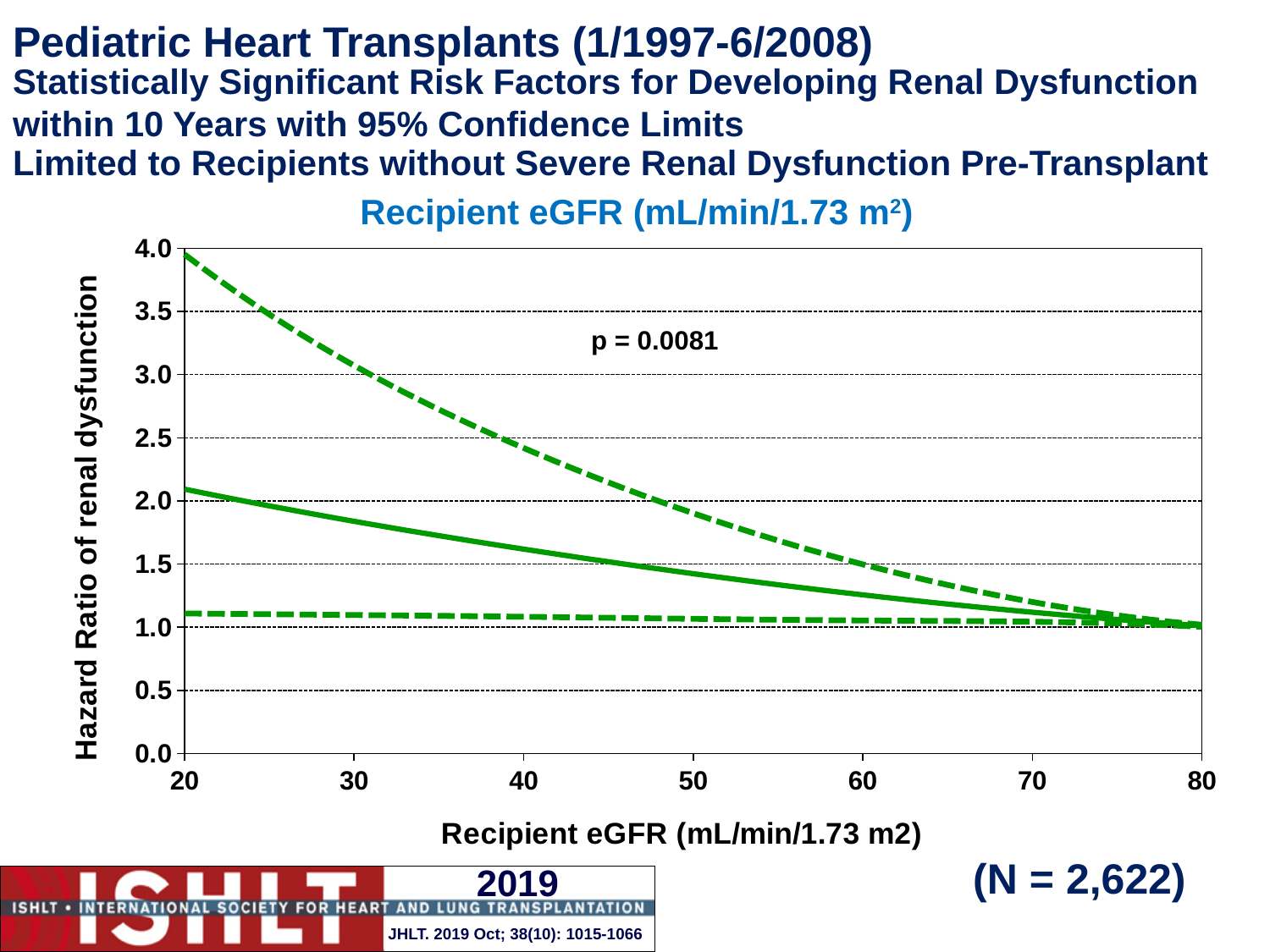
Is the value of the upper dashed line at an eGFR of 20 greater or less than 3.5? greater Is the value of the solid hazard ratio line at an eGFR of 20 greater or less than 1.5? greater Is the value of the solid hazard ratio line at an eGFR of 80 greater or less than 1.5? less What p-value is printed on the chart? p = 0.0081 Does the solid line (hazard ratio) rise or fall as recipient eGFR increases from 20 to 80? fall How many lines are plotted on the chart? 3 At an eGFR of 30, which line is higher: the upper dashed line or the solid line? the upper dashed line What is the label of the y-axis? Hazard Ratio of renal dysfunction What kind of chart is shown on the slide? line chart Does the upper dashed confidence limit rise or fall as recipient eGFR increases? fall